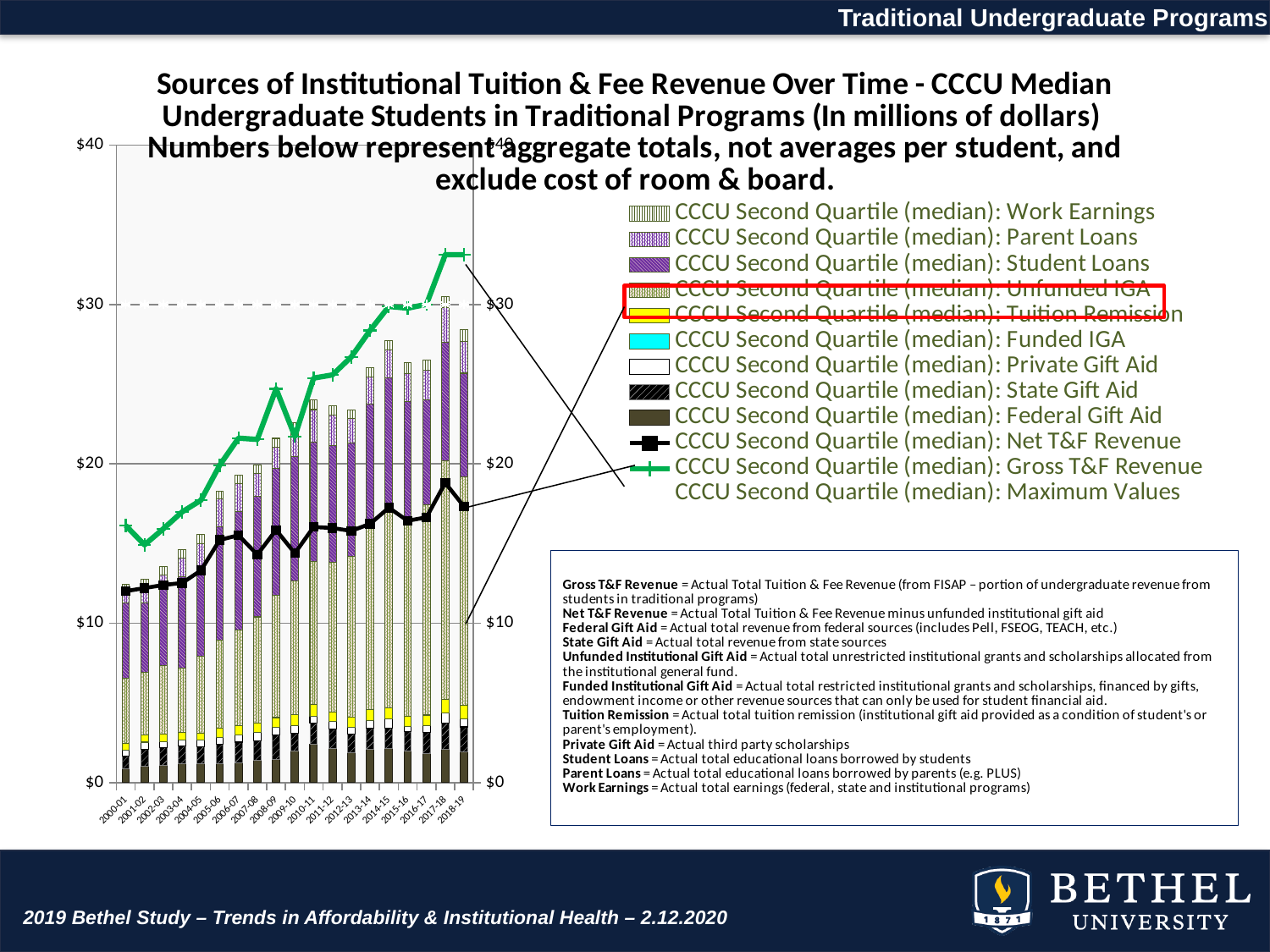
What is the highest value shown on the chart's vertical axis? $40 What colour is the Gross T&F Revenue line in the chart? green Is the Net T&F Revenue value for 2017-18 greater or less than $20? less What kind of chart is shown on the slide? combination bar and line chart How many academic years are plotted along the x axis of the chart? 19 Does the Gross T&F Revenue line generally rise or fall from 2000-01 to 2018-19? rise How many series does the chart's legend list? 12 Is the Gross T&F Revenue value for 2017-18 greater or less than $30? greater Is the Gross T&F Revenue value for 2000-01 greater or less than $20? less Which is larger, the Net T&F Revenue value for 2017-18 or for 2018-19? 2017-18 In which year does the Net T&F Revenue line reach its highest value? 2017-18